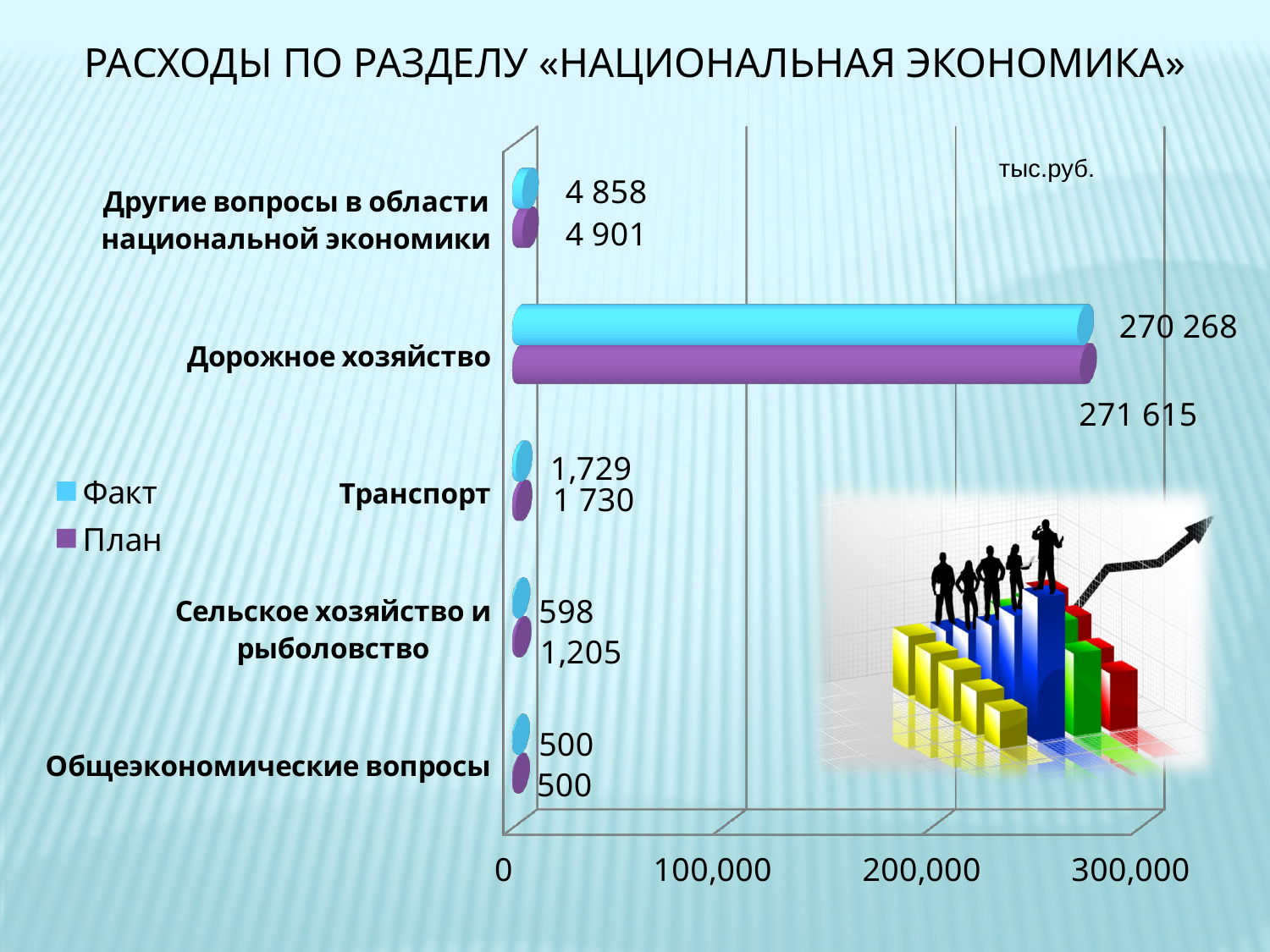
What is the План value for Другие вопросы в области национальной экономики? 4 901 How many series does the legend list? 2 Which category has the lowest План value? Общеэкономические вопросы What is the Факт value for Транспорт? 1,729 What is the План value for Дорожное хозяйство? 271 615 What is the Факт value for Сельское хозяйство и рыболовство? 598 What is the Факт value for Дорожное хозяйство? 270 268 What type of chart is shown on the slide? Bar chart Which category has the highest Факт value? Дорожное хозяйство Which is larger for Другие вопросы в области национальной экономики: the Факт value or the План value? План How many categories are shown on the chart? 5 What is the difference between the План and Факт values for Сельское хозяйство и рыболовство? 607